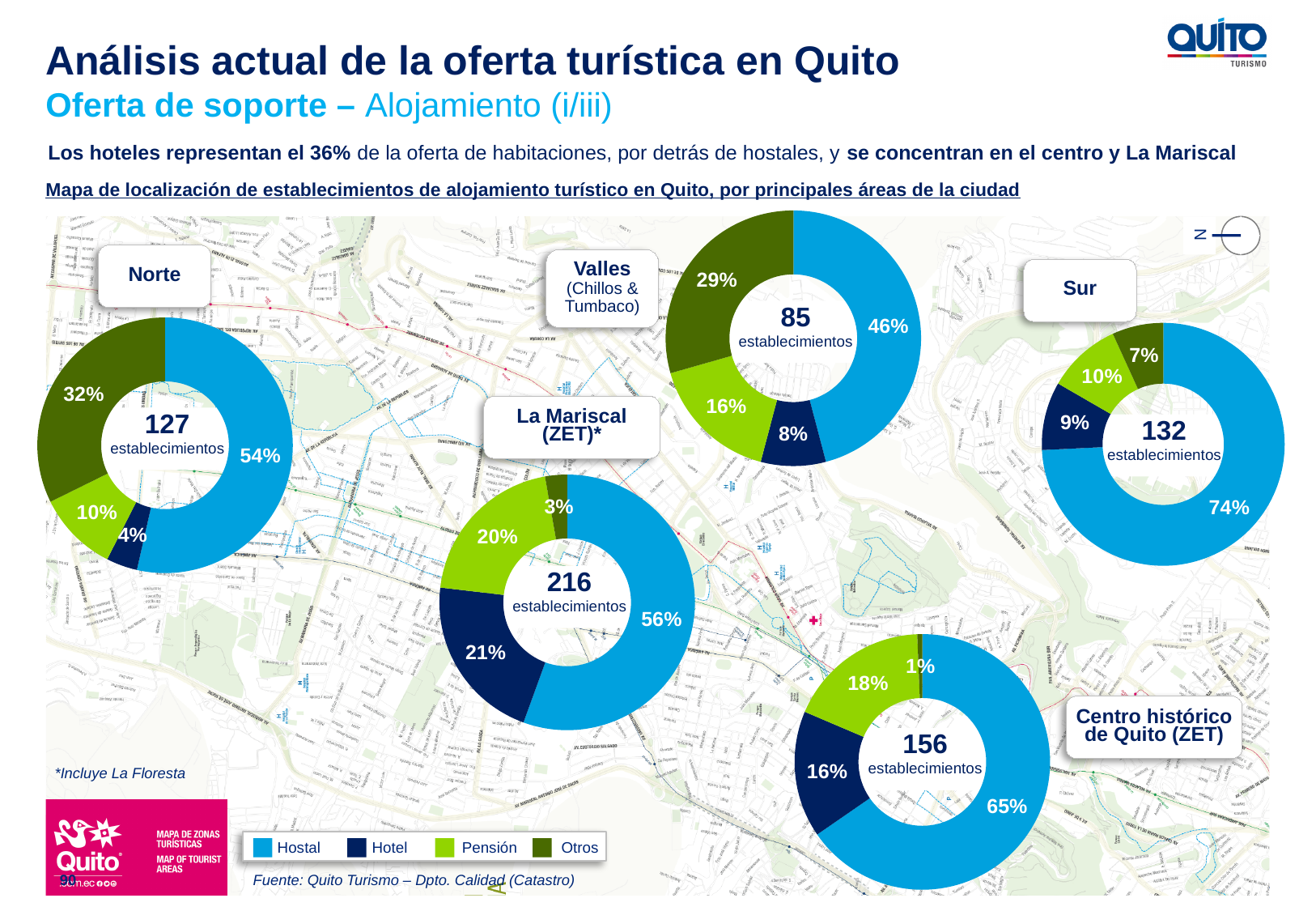
Which area chart shows the lowest number of establishments? Valles (Chillos & Tumbaco) How many entries does the legend list? 4 In the La Mariscal (ZET) chart, which category has the smallest share? Otros In the Centro histórico de Quito (ZET) chart, what share of establishments are Pensión? 18% In the La Mariscal (ZET) chart, how many establishments are there in total? 216 In the Sur chart, what share of establishments are Hotel? 9% In the Norte chart, what share of establishments are Hostal? 54% What kind of chart is used for each area on the map? Donut chart In the Sur chart, which is larger: the Pensión share or the Otros share? Pensión In the Norte chart, what is the difference between the Hostal share and the Otros share? 22% Which area chart shows the highest number of establishments? La Mariscal (ZET) In the Valles (Chillos & Tumbaco) chart, which category has the largest share? Hostal